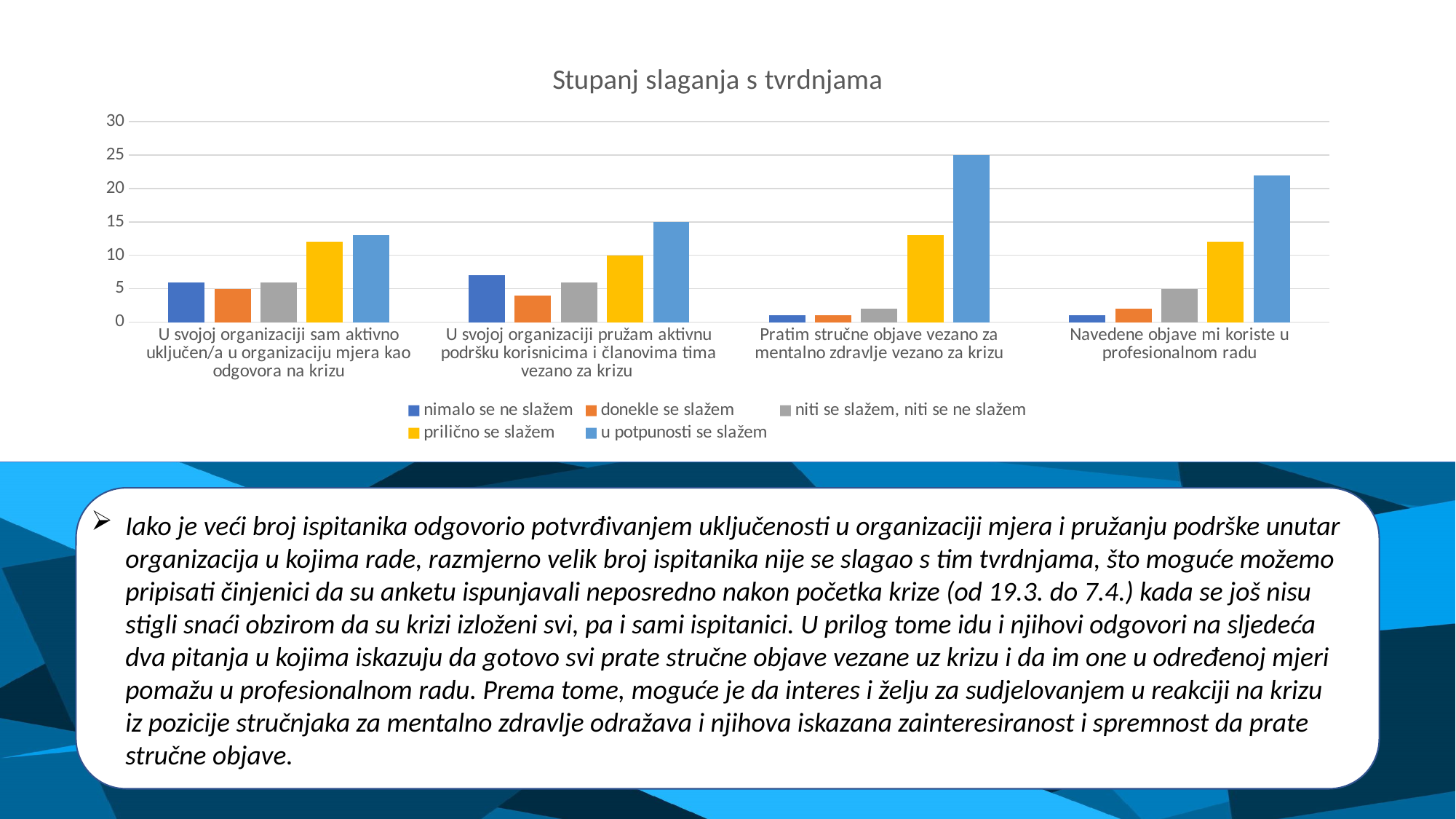
Is the value of 'nimalo se ne slažem' for 'U svojoj organizaciji pružam aktivnu podršku korisnicima i članovima tima vezano za krizu' greater or less than 5? greater Which category has the lowest value for 'donekle se slažem'? Pratim stručne objave vezano za mentalno zdravlje vezano za krizu What type of chart is shown on the slide? bar chart Is the value of 'u potpunosti se slažem' for 'Pratim stručne objave vezano za mentalno zdravlje vezano za krizu' greater or less than 20? greater What is the title of the chart? Stupanj slaganja s tvrdnjama Which series has the highest value for 'Pratim stručne objave vezano za mentalno zdravlje vezano za krizu'? u potpunosti se slažem Is the value of 'u potpunosti se slažem' for 'Navedene objave mi koriste u profesionalnom radu' greater or less than 20? greater Which is larger for 'U svojoj organizaciji sam aktivno uključen/a u organizaciju mjera kao odgovora na krizu': 'nimalo se ne slažem' or 'prilično se slažem'? prilično se slažem How many statement categories are shown on the x axis? 4 How many series does the legend list? 5 Which colour represents 'u potpunosti se slažem' in the legend? light blue